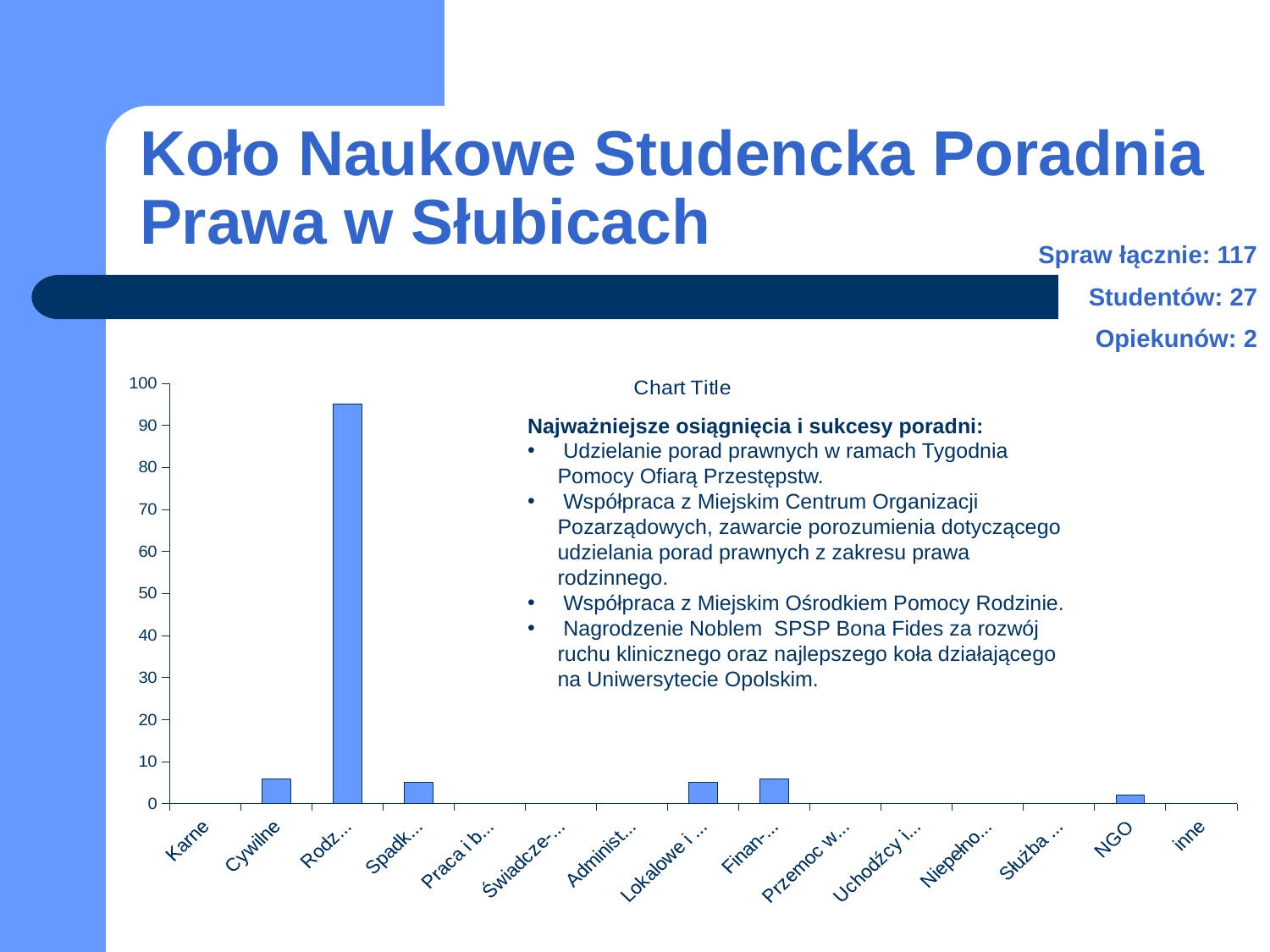
What is the maximum value shown on the chart's vertical axis? 100 Which category has the highest bar in the chart? Rodz... What is the title shown on the chart? Chart Title Which is larger, the value for Rodz... or the value for Cywilne? Rodz... Which is larger, the value for Cywilne or the value for NGO? Cywilne Is the value for Rodz... greater or less than 90? greater Is the value for Cywilne greater or less than 10? less Is the value for Rodz... greater or less than 50? greater Which is larger, the value for NGO or the value for Rodz...? Rodz... What kind of chart is shown on the slide? bar chart How many categories are shown on the x axis of the chart? 15